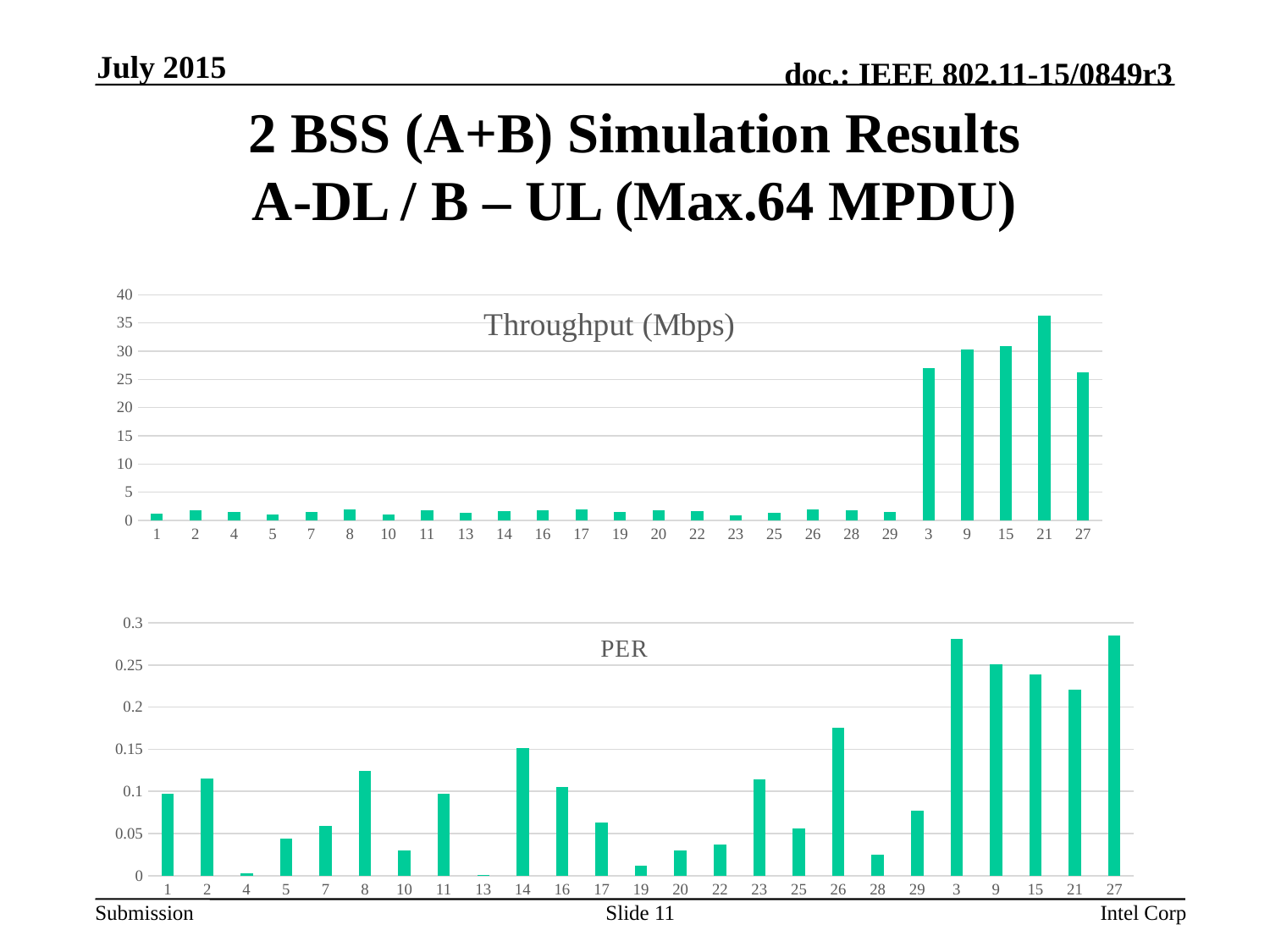
In the PER chart, which is larger, the value for category 26 or category 25? 26 In the Throughput (Mbps) chart, which category has the highest throughput? 21 In the Throughput (Mbps) chart, which is larger, the value for category 15 or category 27? 15 How many categories are plotted on the PER chart? 25 What kind of chart is the PER chart? bar chart In the PER chart, is the value for category 26 greater or less than 0.15? greater In the Throughput (Mbps) chart, is the value for category 21 greater or less than 35? greater How many categories are plotted on the Throughput (Mbps) chart? 25 In the PER chart, is the value for category 21 greater or less than 0.25? less What kind of chart is the Throughput (Mbps) chart? bar chart